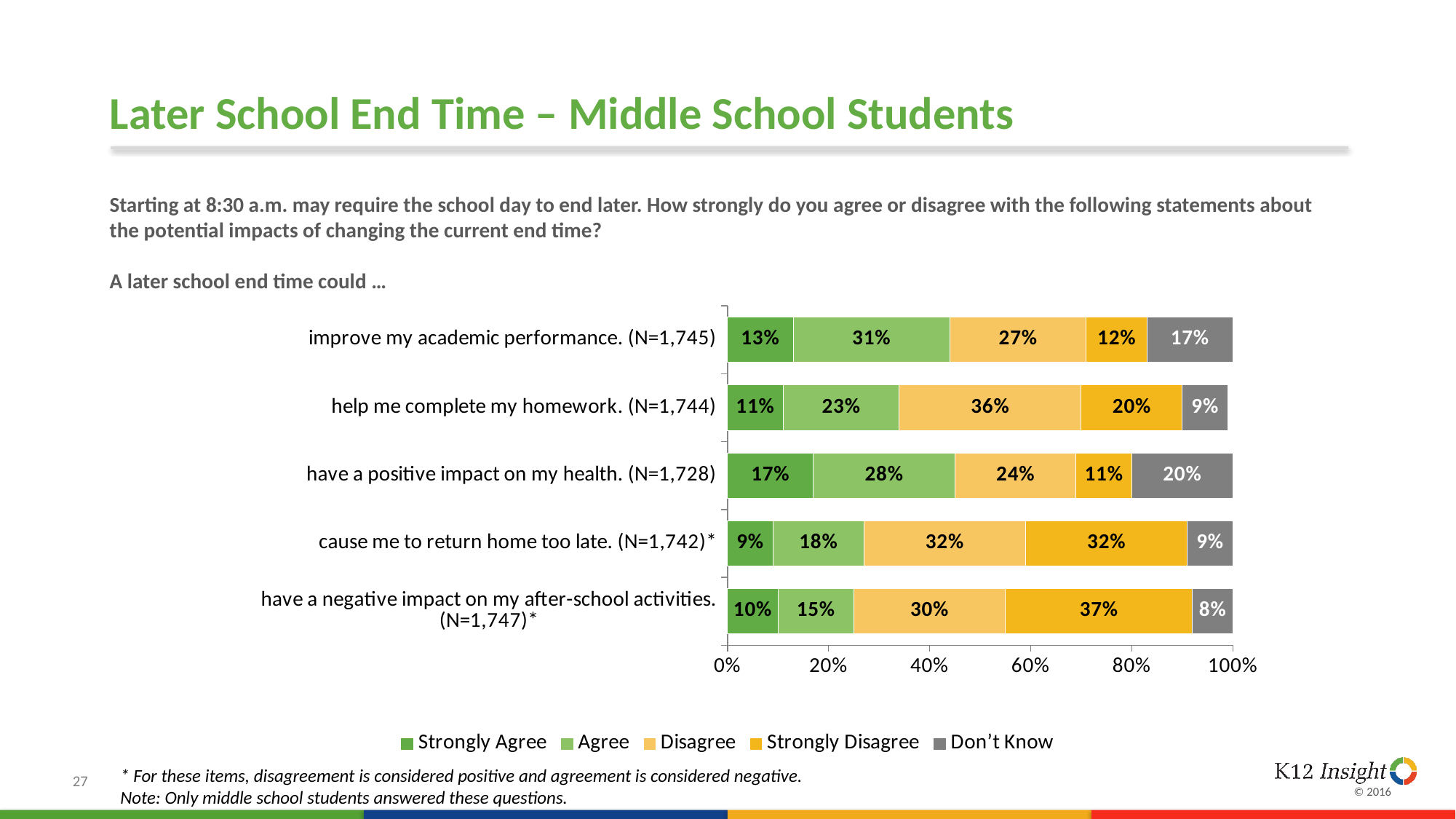
Which statement has the highest Don't Know percentage? have a positive impact on my health Which statement has the highest Strongly Disagree percentage? have a negative impact on my after-school activities What is the difference in percentage points between the Agree value for 'improve my academic performance' and the Agree value for 'have a negative impact on my after-school activities'? 16 percentage points What colour represents the Don't Know responses in the chart? Grey Which has a larger Strongly Disagree percentage: 'cause me to return home too late' or 'help me complete my homework'? cause me to return home too late What percentage of middle school students strongly agree that a later school end time could have a positive impact on their health? 17% What is the Disagree percentage for the statement 'help me complete my homework'? 36% What percentage of students strongly disagree that a later school end time could have a negative impact on their after-school activities? 37% How many statements are shown in the chart? 5 How many response categories does the legend list? 5 Which statement has the lowest Strongly Agree percentage? cause me to return home too late What type of chart is shown on the slide? Stacked bar chart